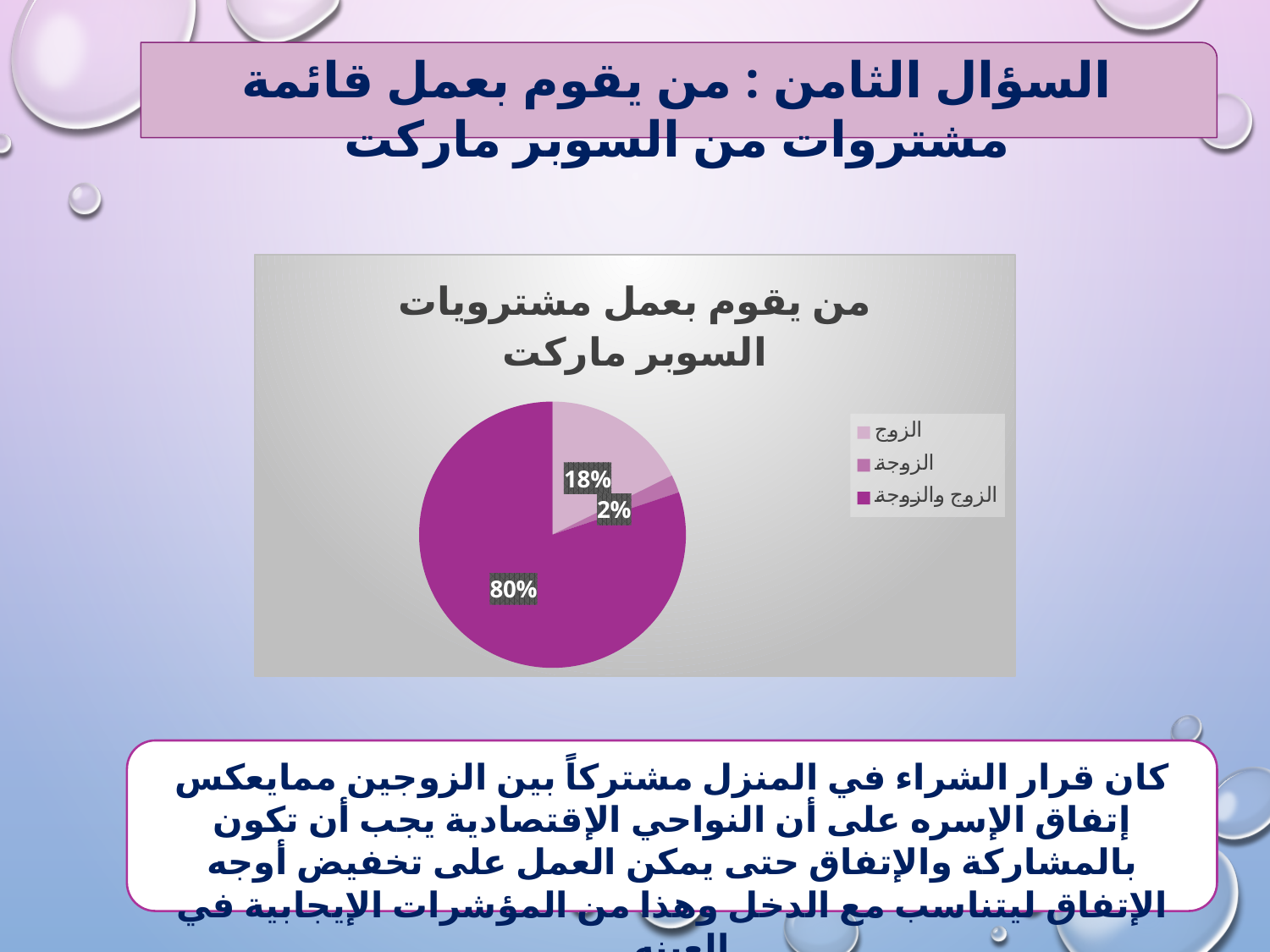
How many entries does the legend list? 3 What percentage is shown for الزوجة? 2% What percentage is shown for الزوج والزوجة? 80% What is the title of the chart? من يقوم بعمل مشترويات السوبر ماركت What kind of chart is shown on the slide? pie chart What is the combined share of الزوج and الزوجة? 20% Which category has the smallest share of the pie? الزوجة Which is larger, the share for الزوج or the share for الزوجة? الزوج How many slices does the pie chart have? 3 Which category has the largest share of the pie? الزوج والزوجة What is the difference in percentage points between الزوج والزوجة and الزوج? 62 What percentage is shown for الزوج? 18%